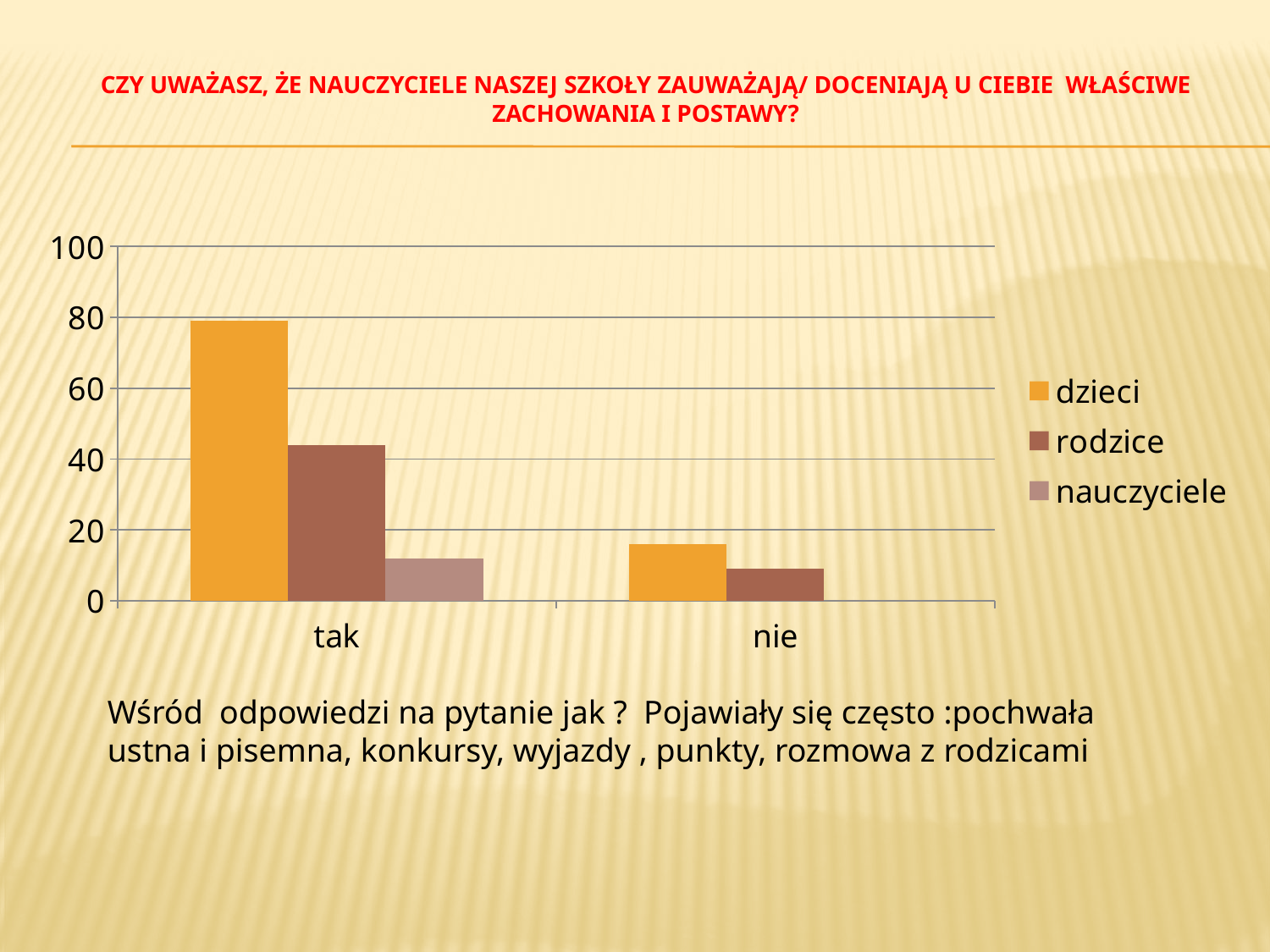
In the "nie" category, which is larger, dzieci or rodzice? dzieci What are the three entries listed in the legend? dzieci, rodzice, nauczyciele Is the value for dzieci in the "tak" category greater or less than 60? greater How many categories are shown on the x axis? 2 Which series has the lowest value for "tak"? nauczyciele Is the value for dzieci in the "nie" category greater or less than 20? less Is the value for nauczyciele in the "tak" category greater or less than 20? less Which series has the highest value for "tak"? dzieci For dzieci, which category has the larger value, "tak" or "nie"? tak What kind of chart is shown on the slide? bar chart How many series does the legend list? 3